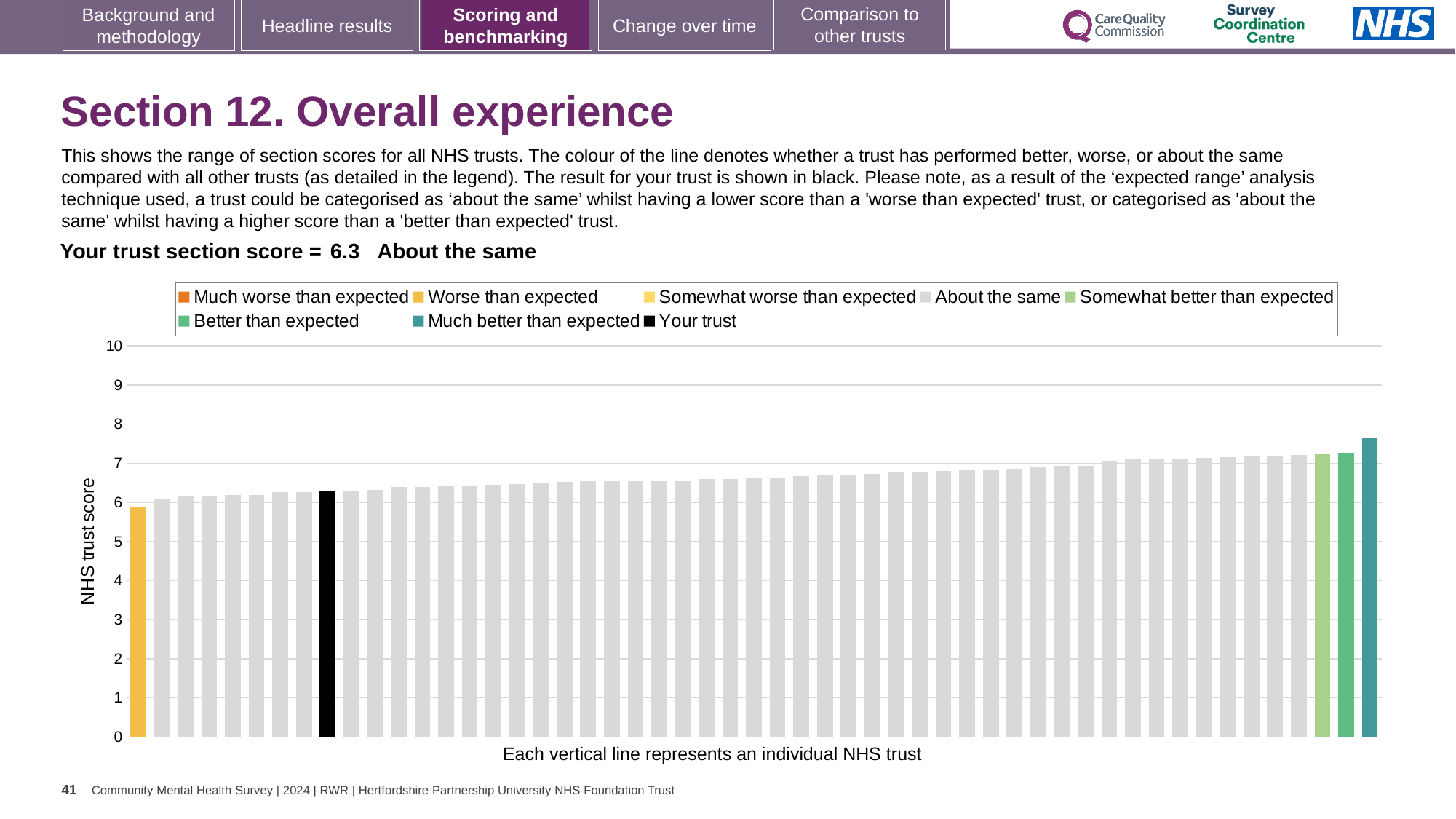
Is the value for your trust greater or less than 5? greater What is the label on the vertical axis of the chart? NHS trust score How many entries does the chart legend list? 8 Which legend category does the shortest bar in the chart belong to? Worse than expected Which performance category is your trust placed in for this section? About the same Which legend category does the tallest bar in the chart belong to? Much better than expected What is the section score for your trust shown on the slide? 6.3 Is the value of the tallest bar greater or less than 8? less What colour is the bar representing your trust? black Do the bar values rise or fall from left to right across the chart? rise What kind of chart is shown on the slide? bar chart Which bar is taller, the leftmost bar or the rightmost bar? the rightmost bar